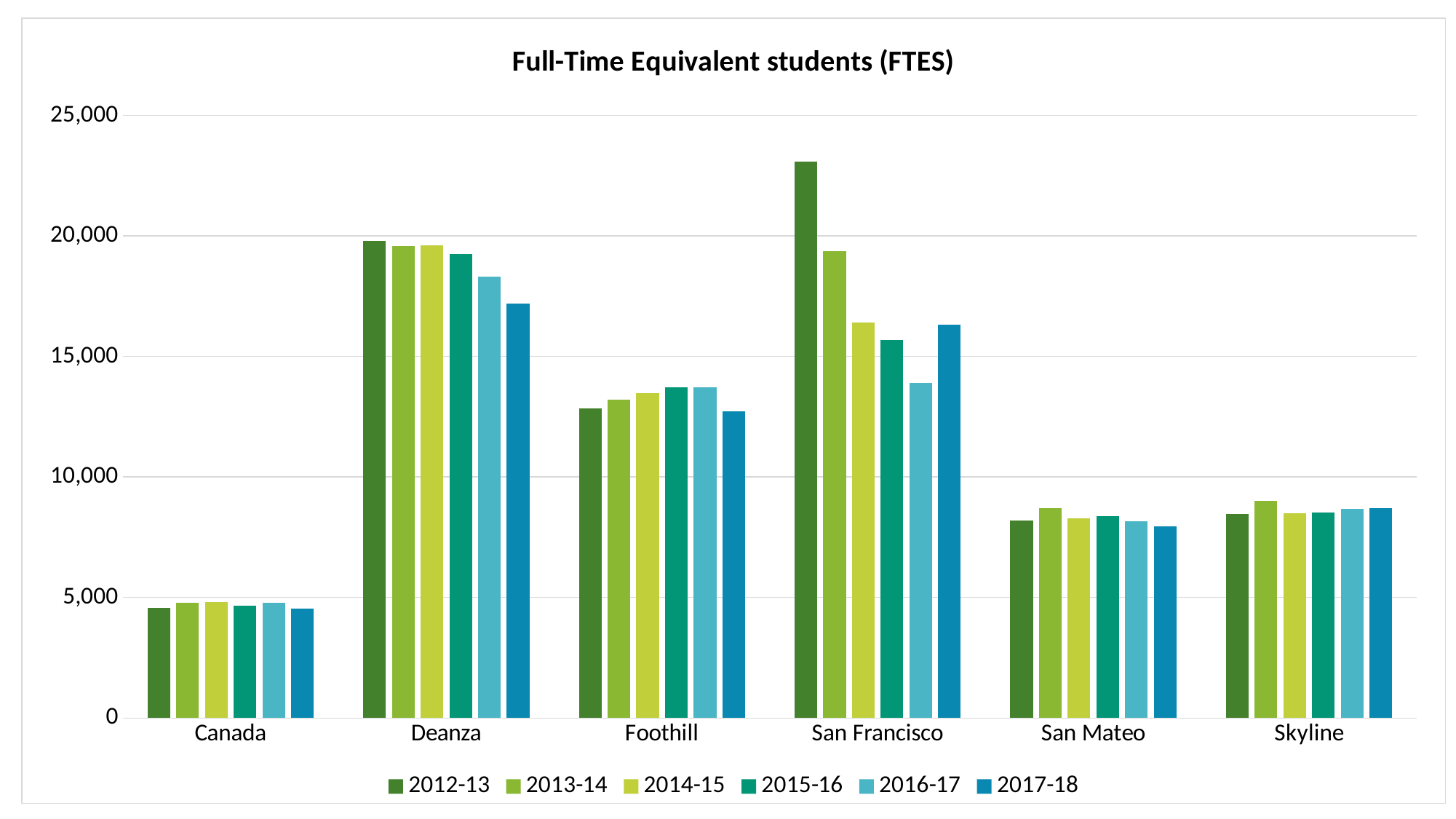
How many series does the legend list? 6 Which is larger in 2017-18, the value for Foothill or the value for San Francisco? San Francisco Is the value for Canada in 2012-13 greater or less than 5,000? less Is the value for Deanza in 2017-18 greater or less than 20,000? less What is the title of the chart? Full-Time Equivalent students (FTES) How many colleges are shown on the x axis of the chart? 6 Is the value for San Francisco in 2012-13 greater or less than 20,000? greater Do the values for Deanza rise or fall from 2012-13 to 2017-18? fall Which college has the highest bar for 2012-13? San Francisco What kind of chart is shown on the slide? bar chart Which college has the lowest values across all years? Canada